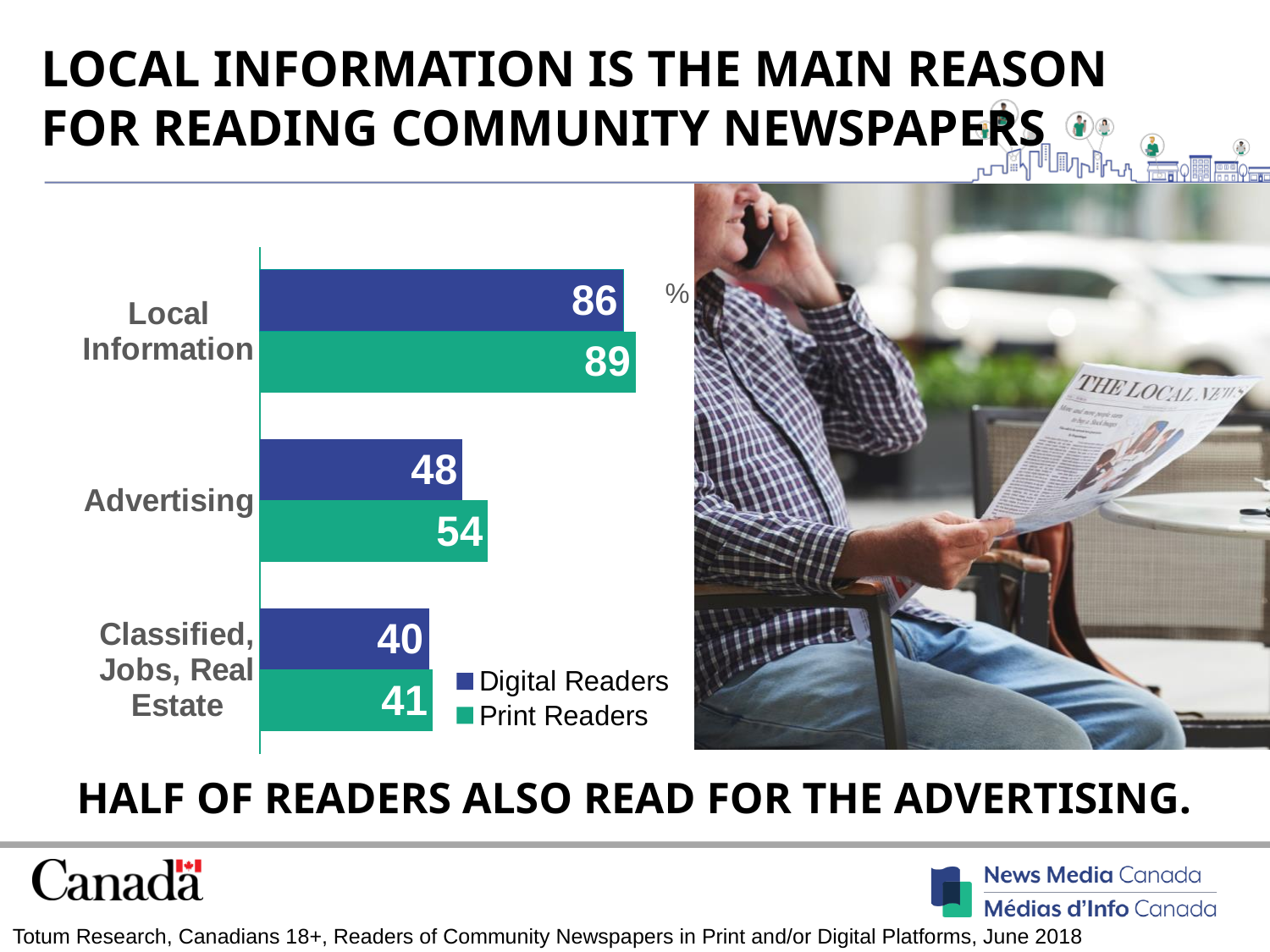
How many categories are shown in the chart? 3 What is the value for Print Readers for Classified, Jobs, Real Estate? 41 For Advertising, which is larger: Digital Readers or Print Readers? Print Readers How many series does the legend list? 2 What kind of chart is shown on the slide? Bar chart What is the value for Print Readers for Advertising? 54 Which category has the highest value for Print Readers? Local Information What is the value for Digital Readers for Local Information? 86 What is the difference between Print Readers and Digital Readers for Local Information? 3 Which category has the lowest value for Digital Readers? Classified, Jobs, Real Estate What is the difference between Print Readers and Digital Readers for Advertising? 6 Which colour represents Print Readers in the chart? Green